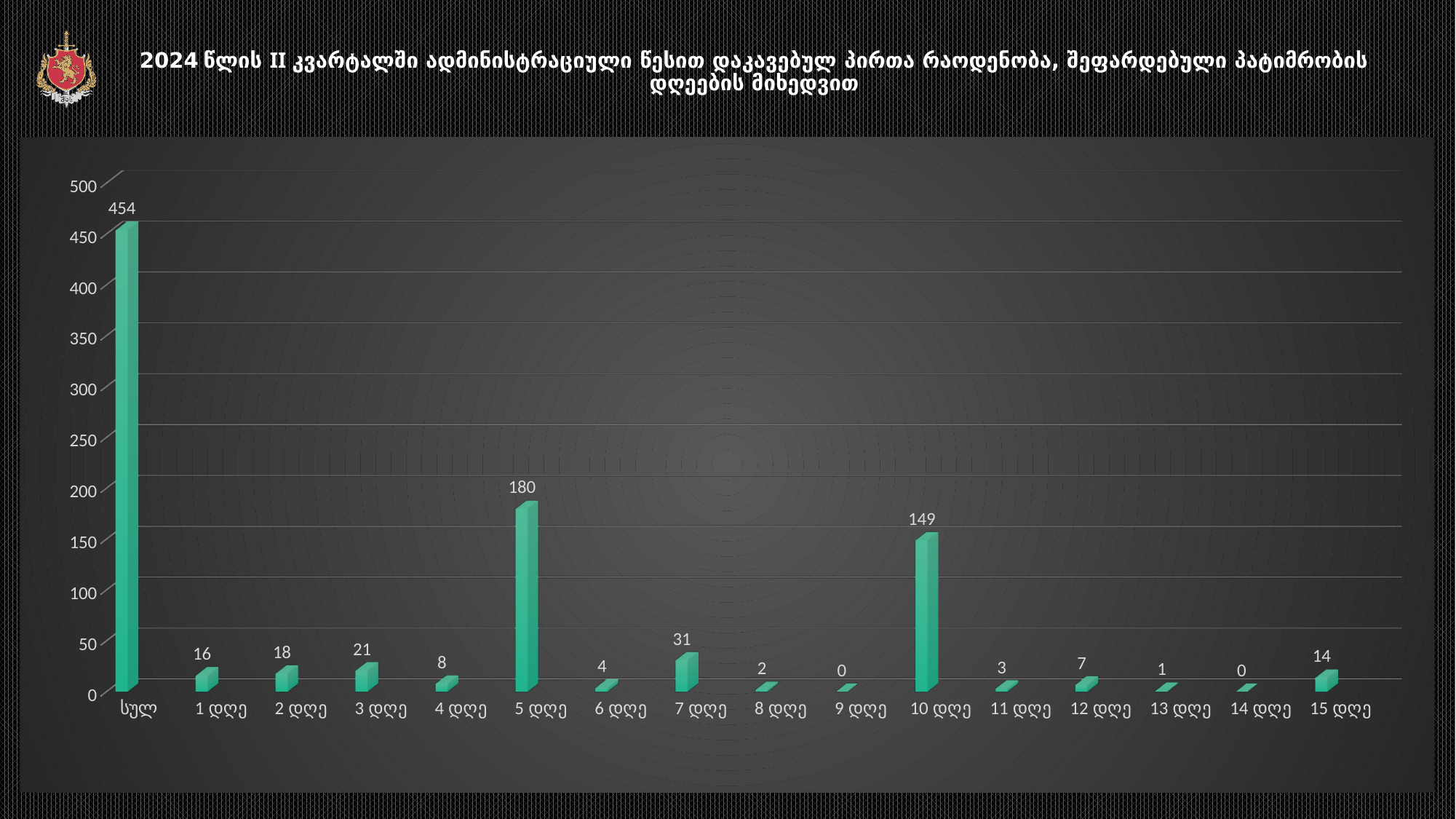
What kind of chart is shown on the slide? Bar chart What is the difference between the values for "5 დღე" and "10 დღე"? 31 What is the value for "15 დღე"? 14 What is the value for "10 დღე"? 149 What is the value for "5 დღე"? 180 Excluding the "სულ" total bar, which category has the highest value? 5 დღე How many categories are shown on the x axis? 16 What is the value for the category "სულ"? 454 Which is larger, the value for "3 დღე" or the value for "2 დღე"? 3 დღე Which categories have a value of 0? 9 დღე and 14 დღე What is the value for "7 დღე"? 31 What is the highest value shown on the vertical axis? 500